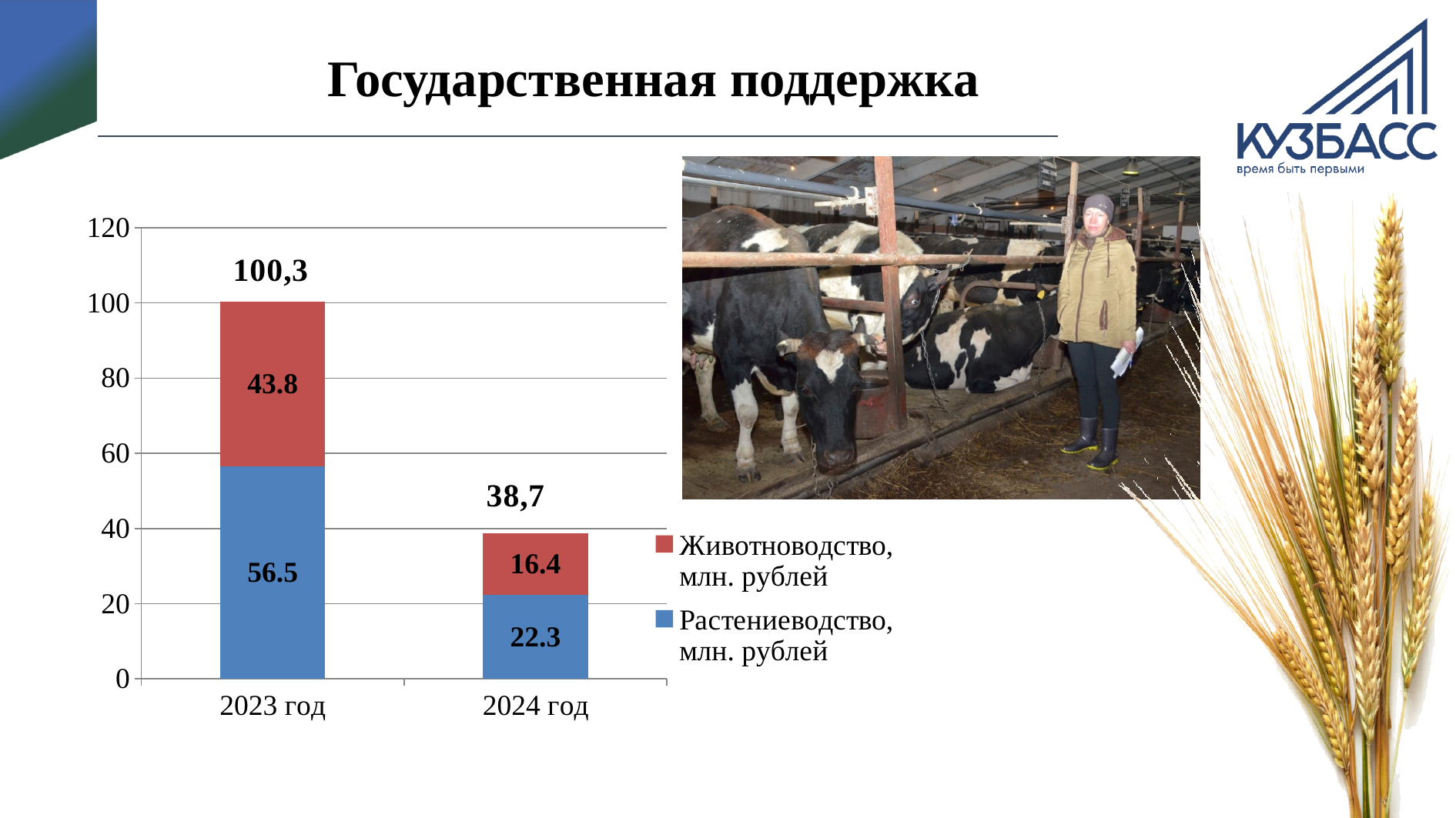
Which year has the higher total value? 2023 год What kind of chart is shown on the slide? Stacked bar chart What is the total of the stacked bar for 2023 год? 100,3 What is the difference between the Растениеводство values for 2023 год and 2024 год? 34.2 Which is larger in 2024 год: Растениеводство or Животноводство? Растениеводство What is the value for Животноводство, млн. рублей in 2023 год? 43.8 What is the total of the stacked bar for 2024 год? 38,7 What is the value for Растениеводство, млн. рублей in 2023 год? 56.5 Which colour represents Животноводство, млн. рублей in the chart? Red What is the value for Растениеводство, млн. рублей in 2024 год? 22.3 How many series does the legend list? 2 What is the value for Животноводство, млн. рублей in 2024 год? 16.4